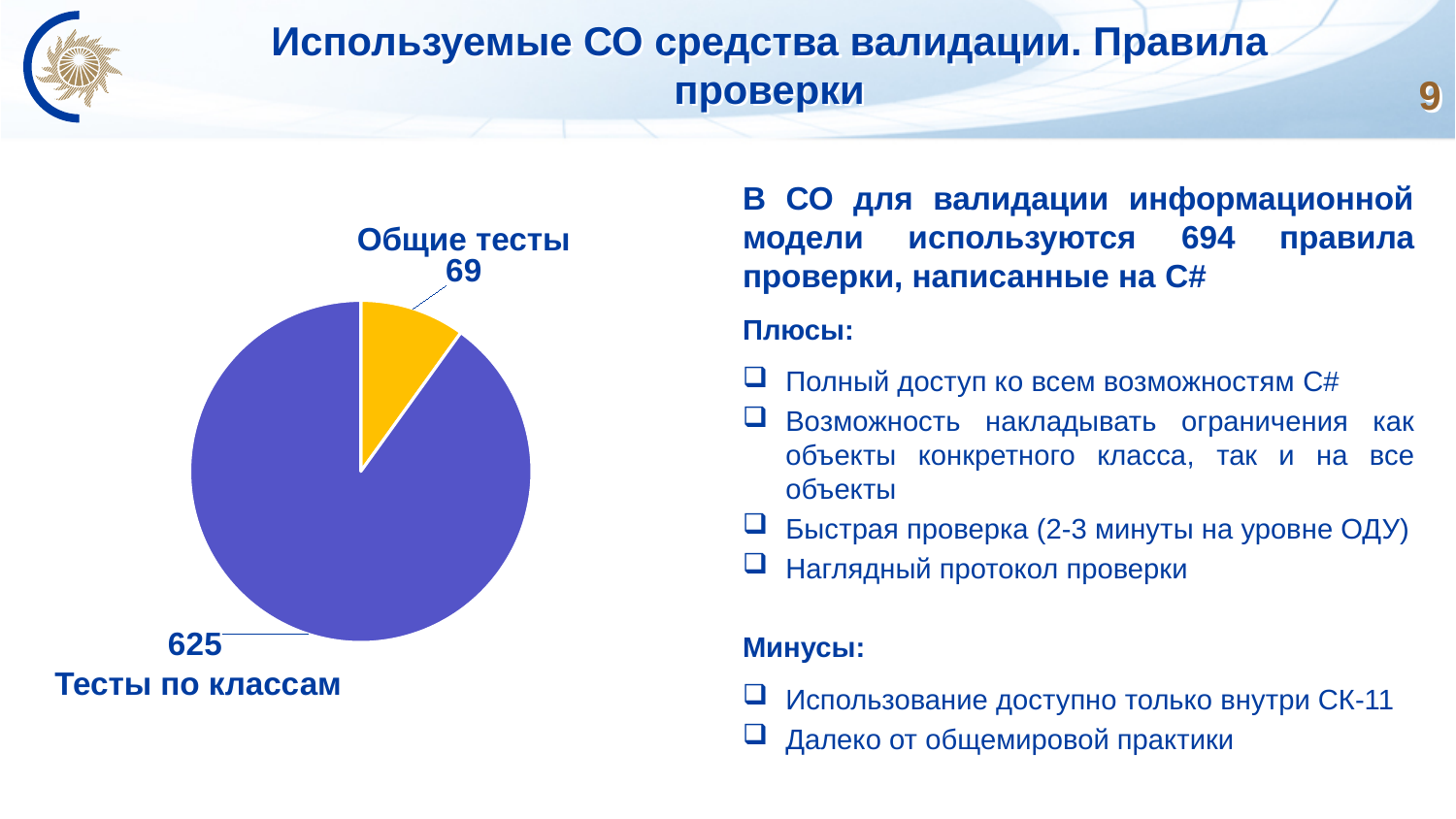
What is the value for Тесты по классам in the pie chart? 625 Which slice of the pie chart is the smallest? Общие тесты What share of the total do Общие тесты make up in the pie chart? 69 out of 694 Which is larger, Общие тесты or Тесты по классам? Тесты по классам How many slices does the pie chart have? 2 What is the difference between the values for Тесты по классам and Общие тесты? 556 What is the total of the two values shown in the pie chart? 694 Which slice of the pie chart is the largest? Тесты по классам What colour is the Тесты по классам slice in the pie chart? Blue What is the value for Общие тесты in the pie chart? 69 What kind of chart is shown on the slide? Pie chart What colour is the Общие тесты slice in the pie chart? Yellow